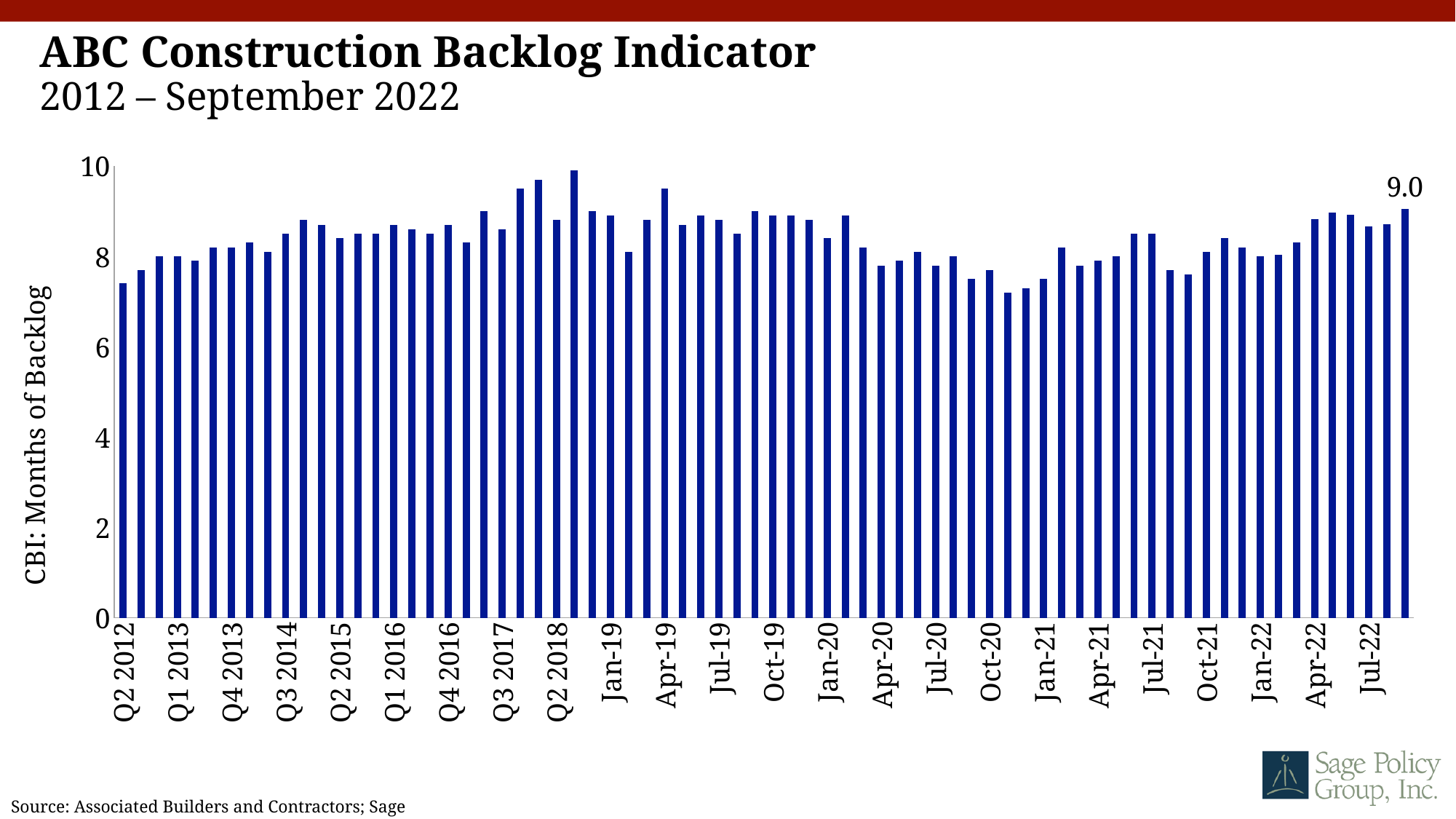
Which is larger, the value for Q2 2012 or the value for September 2022? September 2022 Is the value for Jul-21 greater or less than 8? greater Do the values generally rise or fall between Jan-20 and Oct-20? fall Is the value for Q2 2012 greater or less than 8? less Is the value for Jan-21 greater or less than 8? less What is the value of the final bar (September 2022) in the ABC Construction Backlog Indicator chart? 9.0 What is the title of the chart on the slide? ABC Construction Backlog Indicator Which is larger, the value for Apr-19 or the value for Oct-20? Apr-19 What is the label on the vertical axis of the chart? CBI: Months of Backlog What kind of chart is shown on the slide? bar chart